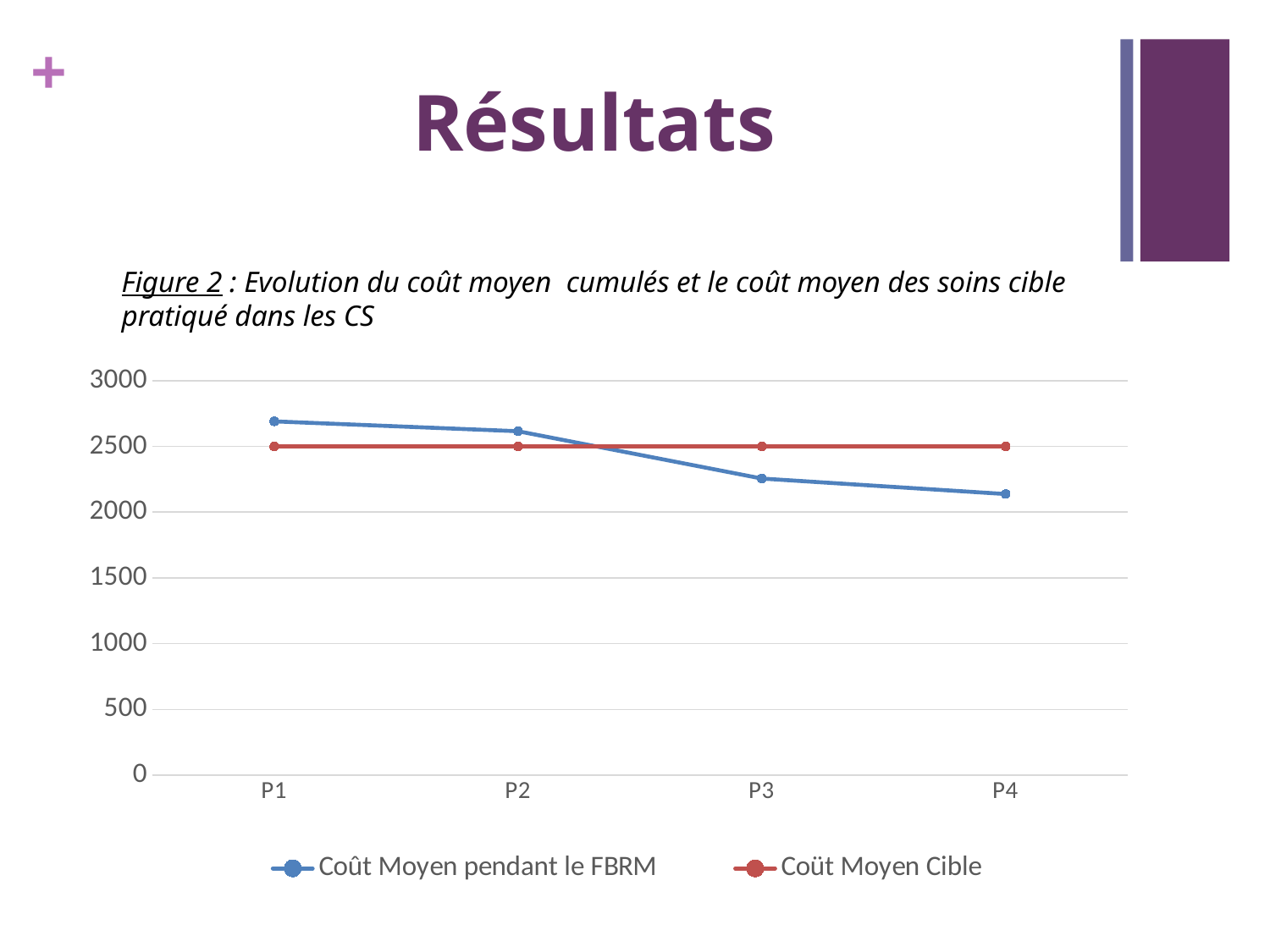
How many points are plotted along the x axis for each series? 4 Is the value of Coût Moyen pendant le FBRM at P4 greater or less than 2000? greater What kind of chart is shown on the slide? line chart How many series does the legend list? 2 Does the Coût Moyen pendant le FBRM series rise or fall from P1 to P4? fall Is the value of Coût Moyen pendant le FBRM at P3 greater or less than 2500? less Is the value of Coût Moyen pendant le FBRM at P1 greater or less than 2500? greater At which point is the Coût Moyen pendant le FBRM series lowest? P4 At P4, which series has the larger value, Coût Moyen pendant le FBRM or Coût Moyen Cible? Coût Moyen Cible What is the value of the Coût Moyen Cible series at P2? 2500 Which colour is used for the Coût Moyen Cible series? red At which point is the Coût Moyen pendant le FBRM series highest? P1